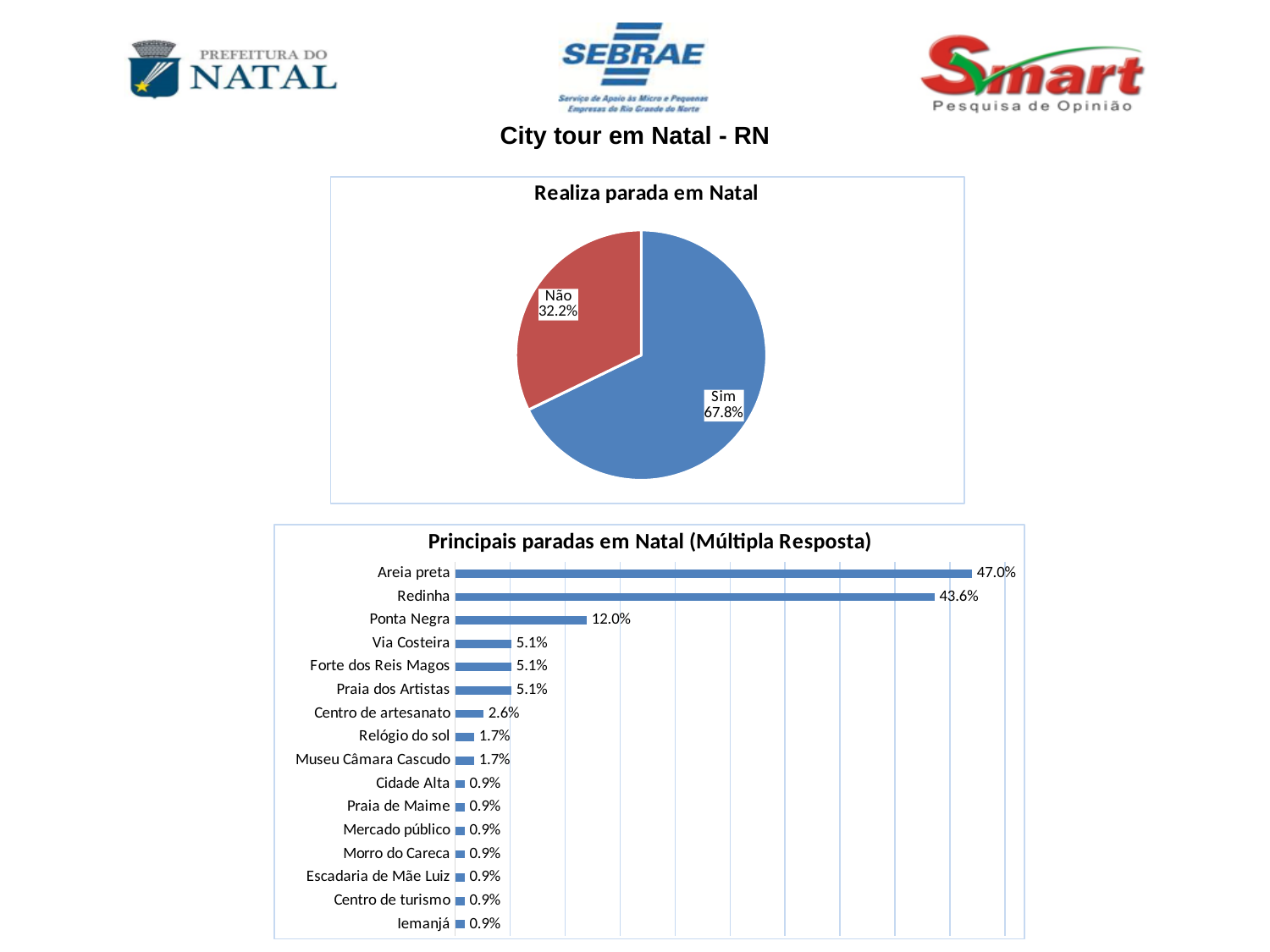
In the 'Realiza parada em Natal' chart, what is the difference between 'Sim' and 'Não'? 35.6% In the 'Principais paradas em Natal' chart, what is the value for Ponta Negra? 12.0% In the 'Realiza parada em Natal' chart, which slice is larger, 'Sim' or 'Não'? Sim In the 'Principais paradas em Natal' chart, what is the value for Redinha? 43.6% In the 'Principais paradas em Natal' chart, what is the difference between Areia preta and Redinha? 3.4% In the 'Principais paradas em Natal' chart, what is the value for Centro de artesanato? 2.6% In the 'Realiza parada em Natal' chart, what share of respondents answered 'Sim'? 67.8% What kind of chart is 'Realiza parada em Natal'? Pie chart How many categories are shown in the 'Principais paradas em Natal' chart? 16 What kind of chart is 'Principais paradas em Natal (Múltipla Resposta)'? Bar chart In the 'Principais paradas em Natal' chart, which category has the highest value? Areia preta In the 'Realiza parada em Natal' chart, what is the value for 'Não'? 32.2%